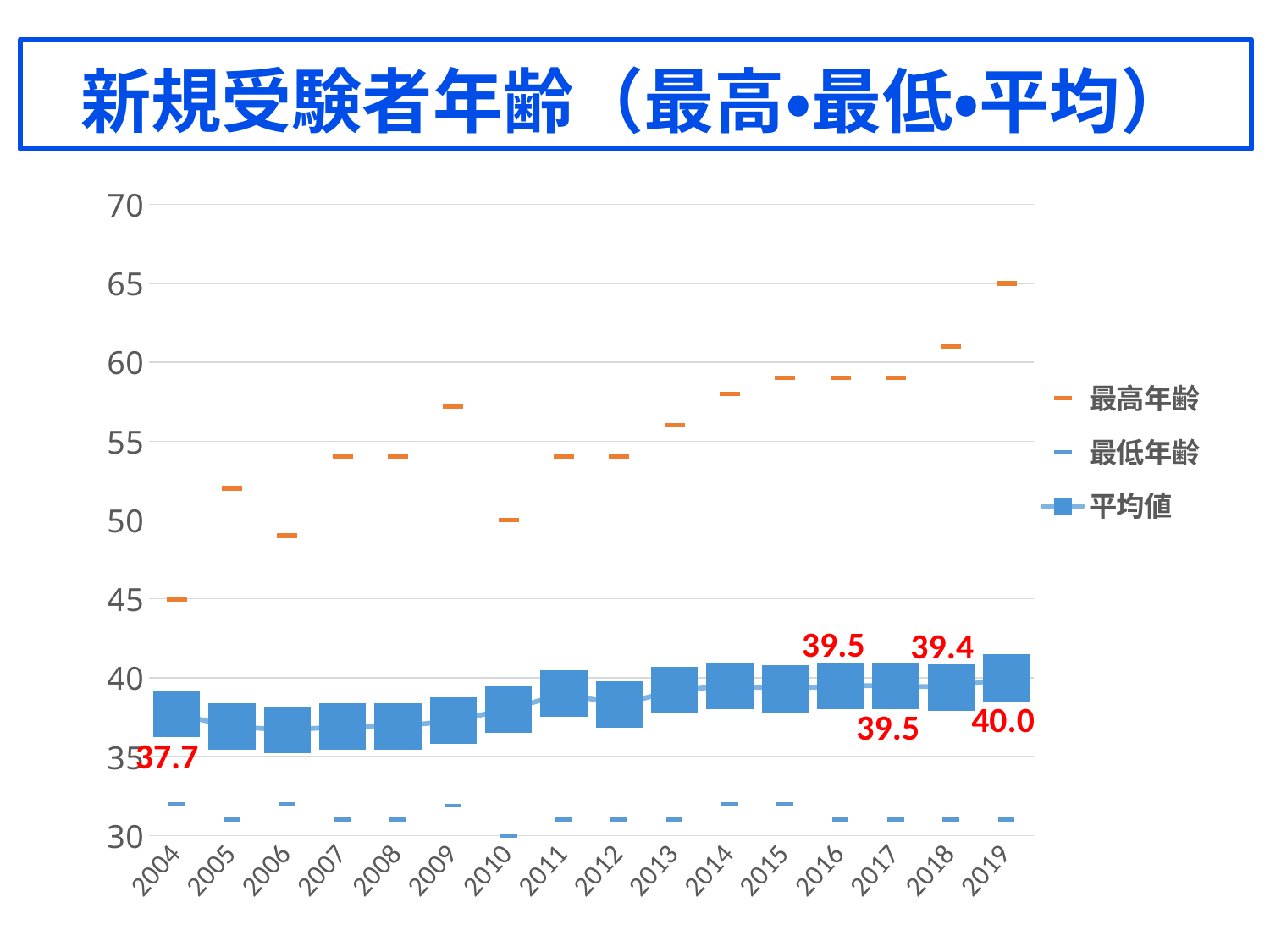
Is the 最高年齢 value for 2009 greater or less than 55? greater Does the 最高年齢 series generally rise or fall from 2004 to 2019? rise How many series does the legend list? 3 In which year is the 最高年齢 (maximum age) highest? 2019 In which year is the 最高年齢 (maximum age) lowest? 2004 What is the 最高年齢 (maximum age) value for 2004? 45 What is the 最高年齢 (maximum age) value for 2019? 65 How many years are shown on the x axis? 16 What is the difference between the 平均値 for 2019 and the 平均値 for 2004? 2.3 What is the 平均値 (average) value for 2019? 40.0 What is the 平均値 (average) value for 2004? 37.7 Is the 最高年齢 value for 2018 greater or less than 60? greater